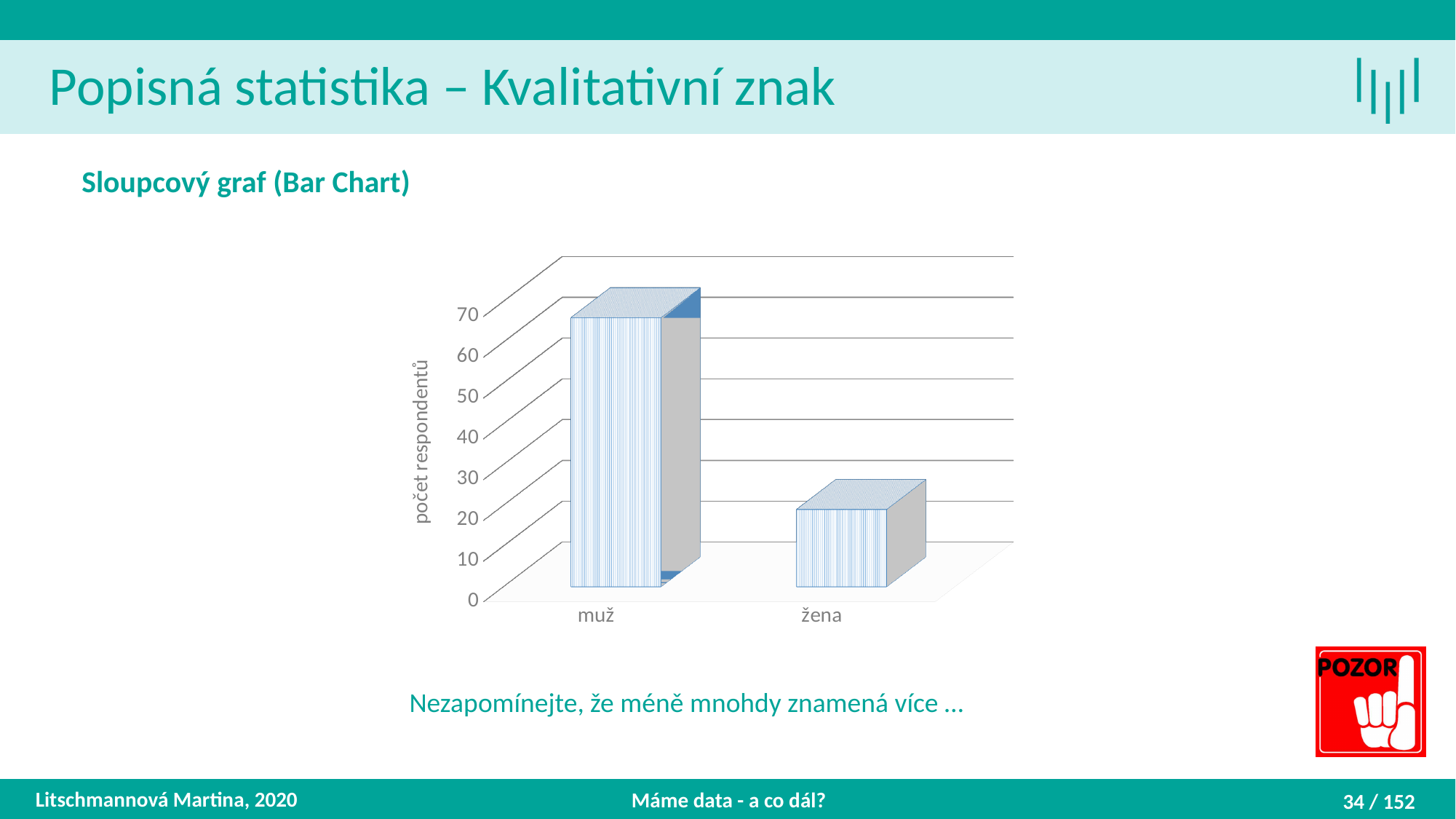
Do the bar values rise or fall from muž to žena along the x axis? fall What kind of chart is shown on the slide? bar chart Is the value for žena greater or less than 10? greater Is the value for muž greater or less than 50? greater Which category has the lowest bar in the chart? žena Which bar is taller, muž or žena? muž What is the label of the vertical axis of the chart? počet respondentů Which category has the highest bar in the chart? muž How many categories are shown on the x axis of the chart? 2 Is the value for žena greater or less than 40? less What is the highest tick value shown on the vertical axis? 70